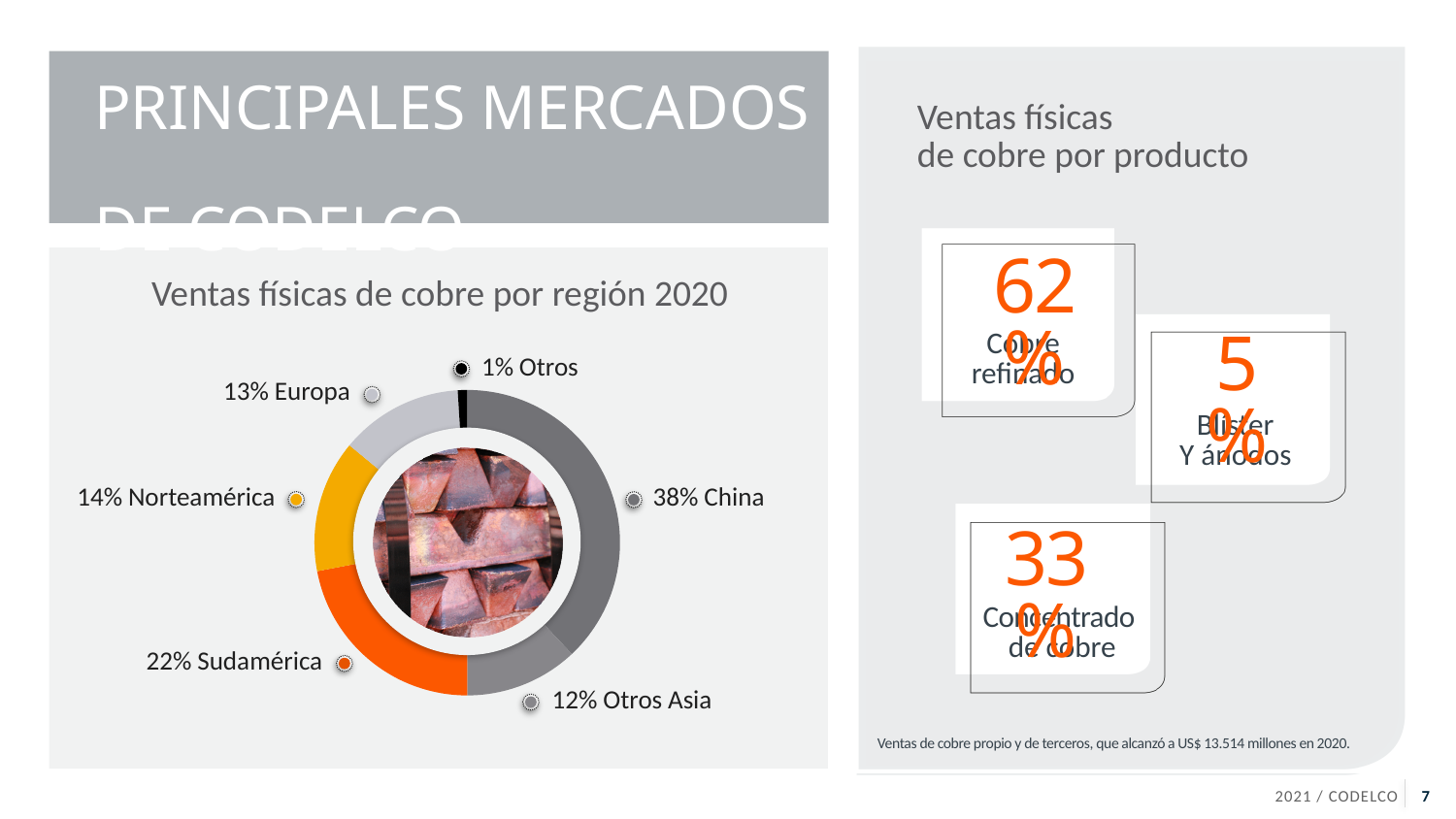
In the chart 'Ventas físicas de cobre por región 2020', what is the value for Sudamérica? 22% What kind of chart is 'Ventas físicas de cobre por región 2020'? Pie (donut) chart In the chart 'Ventas físicas de cobre por región 2020', what is the difference in percentage points between China and Otros Asia? 26 What is the title of the chart on the left side of the slide? Ventas físicas de cobre por región 2020 In the chart 'Ventas físicas de cobre por región 2020', what is the value for Norteamérica? 14% In the chart 'Ventas físicas de cobre por región 2020', what is the value for Otros Asia? 12% In the chart 'Ventas físicas de cobre por región 2020', which is larger, the share for Sudamérica or the share for Otros Asia? Sudamérica How many categories are shown in the chart 'Ventas físicas de cobre por región 2020'? 6 In the chart 'Ventas físicas de cobre por región 2020', which region has the largest share? China In the chart 'Ventas físicas de cobre por región 2020', what share of sales does China account for? 38% In the chart 'Ventas físicas de cobre por región 2020', which is larger, the share for Norteamérica or the share for Europa? Norteamérica In the chart 'Ventas físicas de cobre por región 2020', which category has the smallest share? Otros